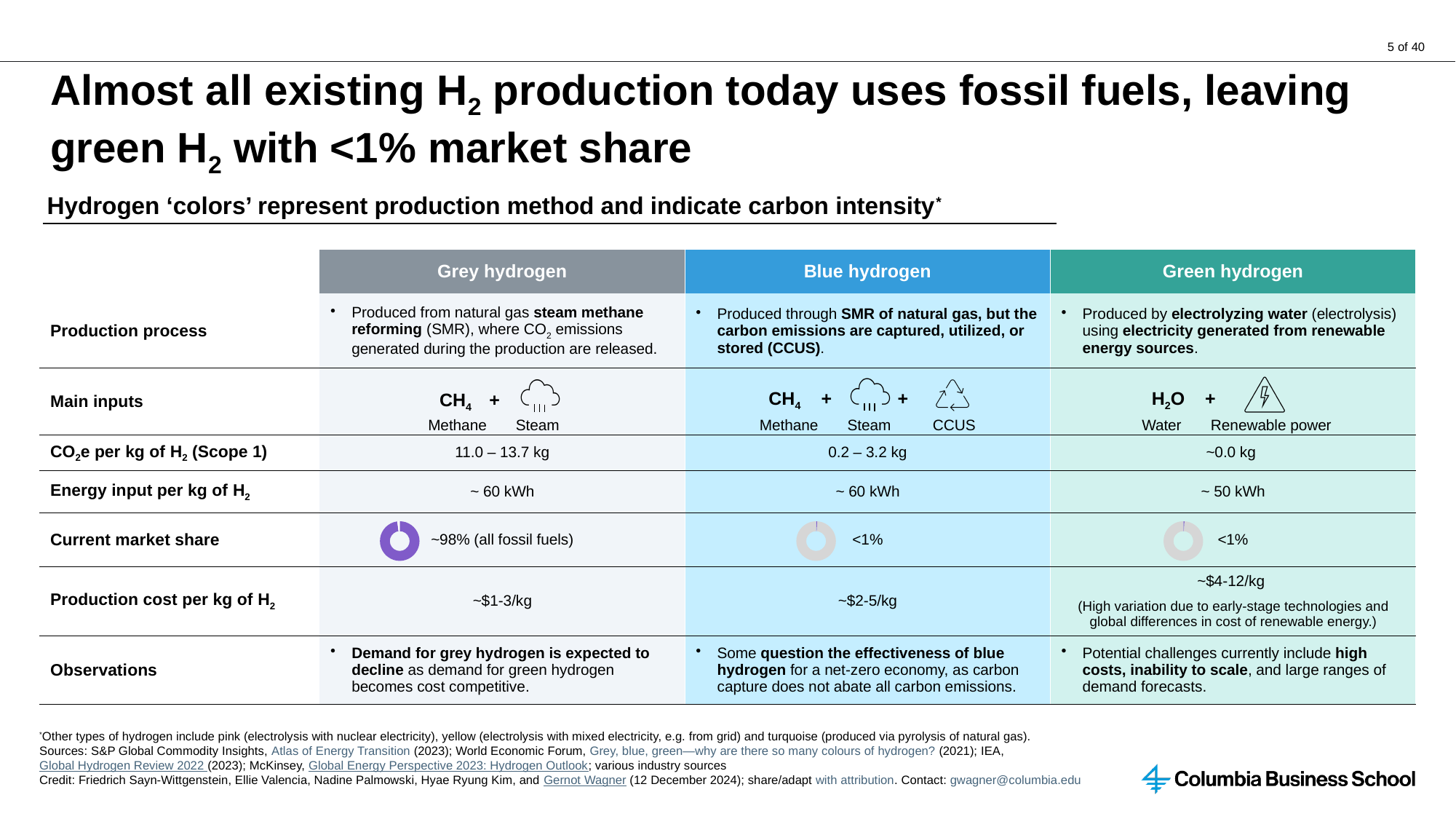
What kind of chart is shown in the 'Current market share' row of the table? Donut (pie) chart What market share label is printed next to the donut chart in the Blue hydrogen column? <1% In the 'Current market share' row, is the filled share of the Grey hydrogen donut chart larger or smaller than that of the Green hydrogen donut chart? Larger What market share label is printed next to the donut chart in the Grey hydrogen column? ~98% (all fossil fuels) How many small donut charts appear in the 'Current market share' row? 3 Which hydrogen type's donut chart in the 'Current market share' row shows the largest filled share? Grey hydrogen What market share label is printed next to the donut chart in the Green hydrogen column? <1% Which row of the table contains the donut charts? Current market share What colour is the filled portion of the Grey hydrogen donut chart in the 'Current market share' row? Purple